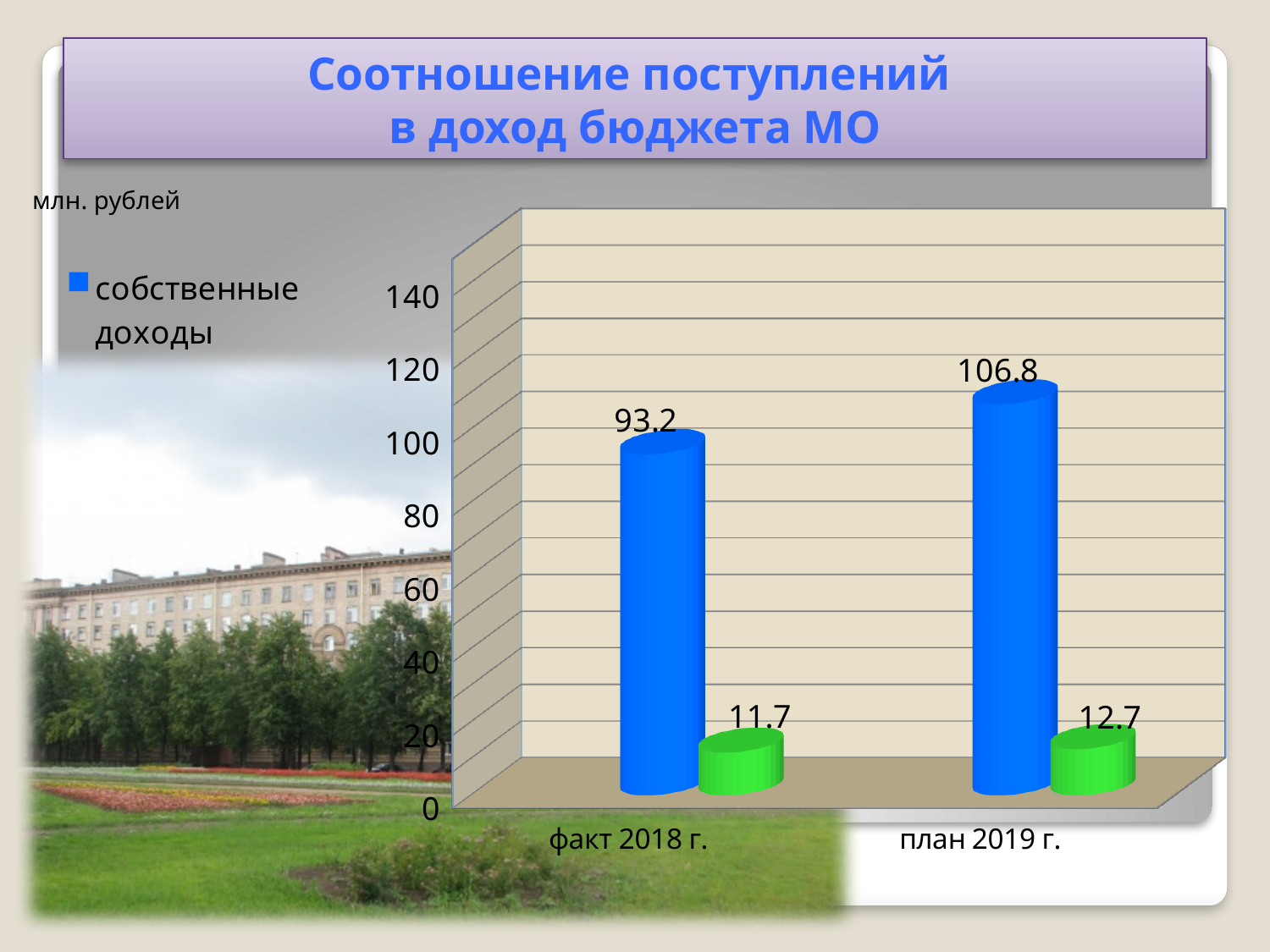
Which category has the higher value of собственные доходы, факт 2018 г. or план 2019 г.? план 2019 г. What is the value of the green series for план 2019 г.? 12.7 In what units are the chart values given, according to the label above the legend? млн. рублей How many categories are shown on the x axis? 2 Which bar on the chart has the lowest value? the green bar for факт 2018 г. (11.7) What is the difference between the green series values for план 2019 г. and факт 2018 г.? 1.0 By how much does собственные доходы for план 2019 г. exceed собственные доходы for факт 2018 г.? 13.6 Does собственные доходы rise or fall from факт 2018 г. to план 2019 г.? rise What is the value of собственные доходы for факт 2018 г.? 93.2 What kind of chart is shown on the slide? bar chart What is the value of the green series for факт 2018 г.? 11.7 What is the value of собственные доходы for план 2019 г.? 106.8